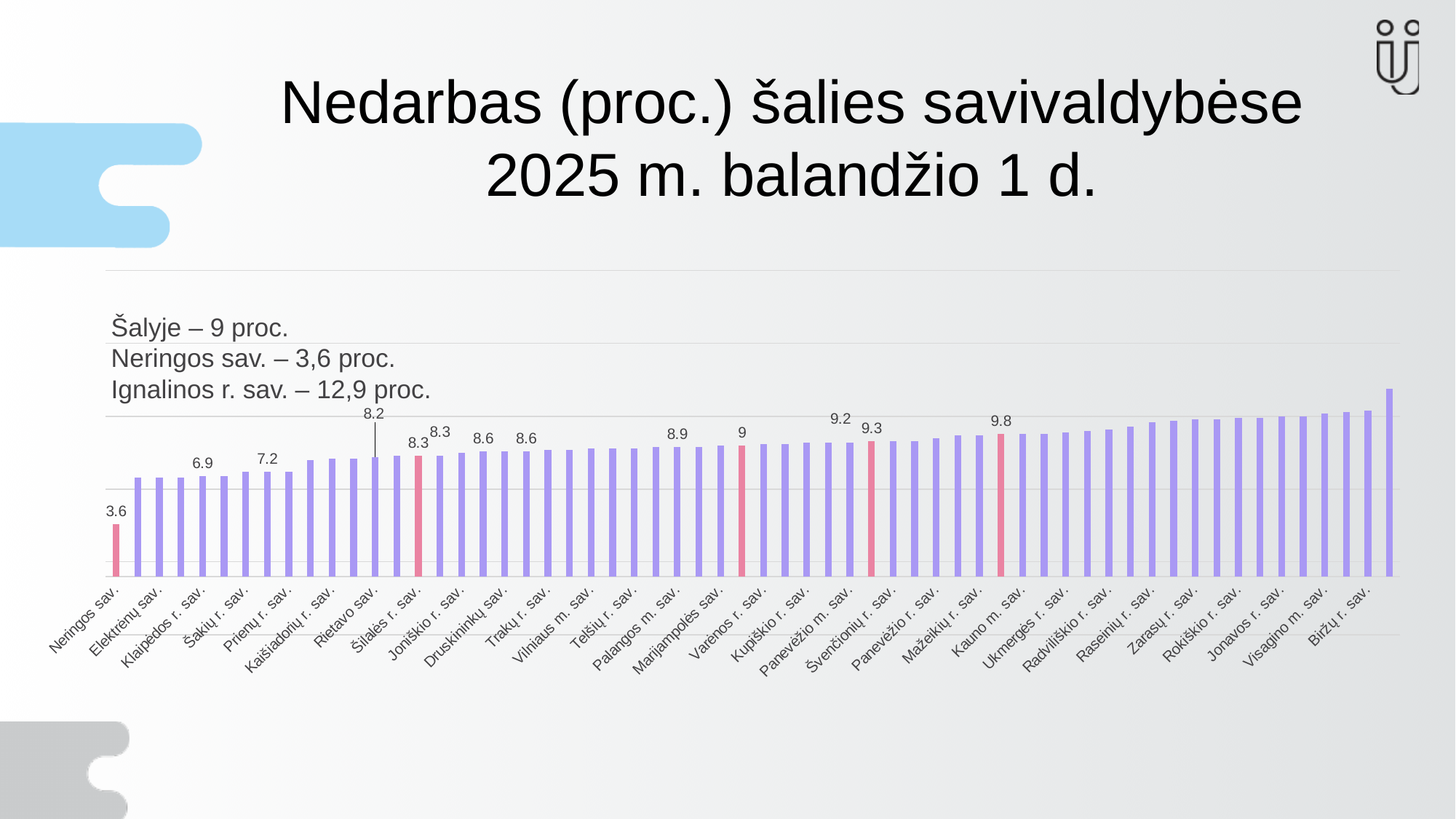
Which has the higher value, Kauno m. sav. or Šilalės r. sav.? Kauno m. sav. What is the value shown for Varėnos r. sav.? 9 What is the value shown for Švenčionių r. sav.? 9.3 What is the unemployment rate shown for Neringos sav.? 3.6 What is the difference between the values for Švenčionių r. sav. and Varėnos r. sav.? 0.3 What kind of chart is shown on the slide? Bar chart Which municipality has the lowest unemployment rate in the chart? Neringos sav. What is the difference between the values for Kauno m. sav. and Neringos sav.? 6.2 What is the value shown for Rietavo sav.? 8.2 What is the value shown for Šilalės r. sav.? 8.3 What value is labelled on the bar for Kauno m. sav.? 9.8 Do the values rise or fall from left to right along the x axis? Rise